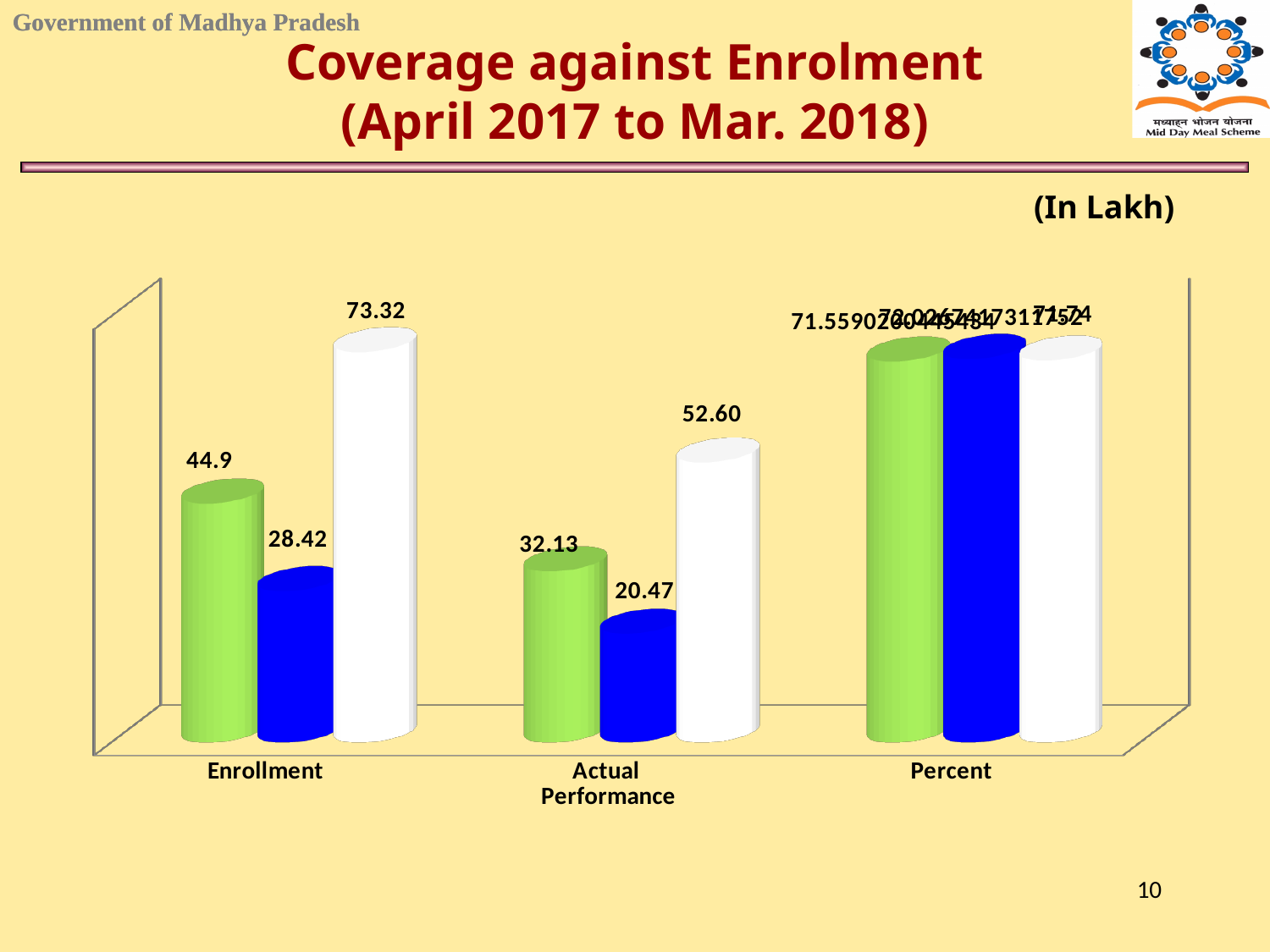
What is the value of the white bar for Enrollment? 73.32 How many categories are shown on the x axis? 3 What is the value of the blue bar for Enrollment? 28.42 Which is larger: the green bar for Enrollment or the green bar for Actual Performance? Enrollment What is the difference between the white bar and the green bar for Enrollment? 28.42 What is the value of the blue bar for Actual Performance? 20.47 What is the value of the green bar for Actual Performance? 32.13 What kind of chart is shown on the slide? bar chart Which bar is the highest in the Enrollment category: green, blue or white? white Which bar is the lowest in the Actual Performance category: green, blue or white? blue What is the value of the white bar for Actual Performance? 52.60 What is the value of the green bar for Enrollment? 44.9